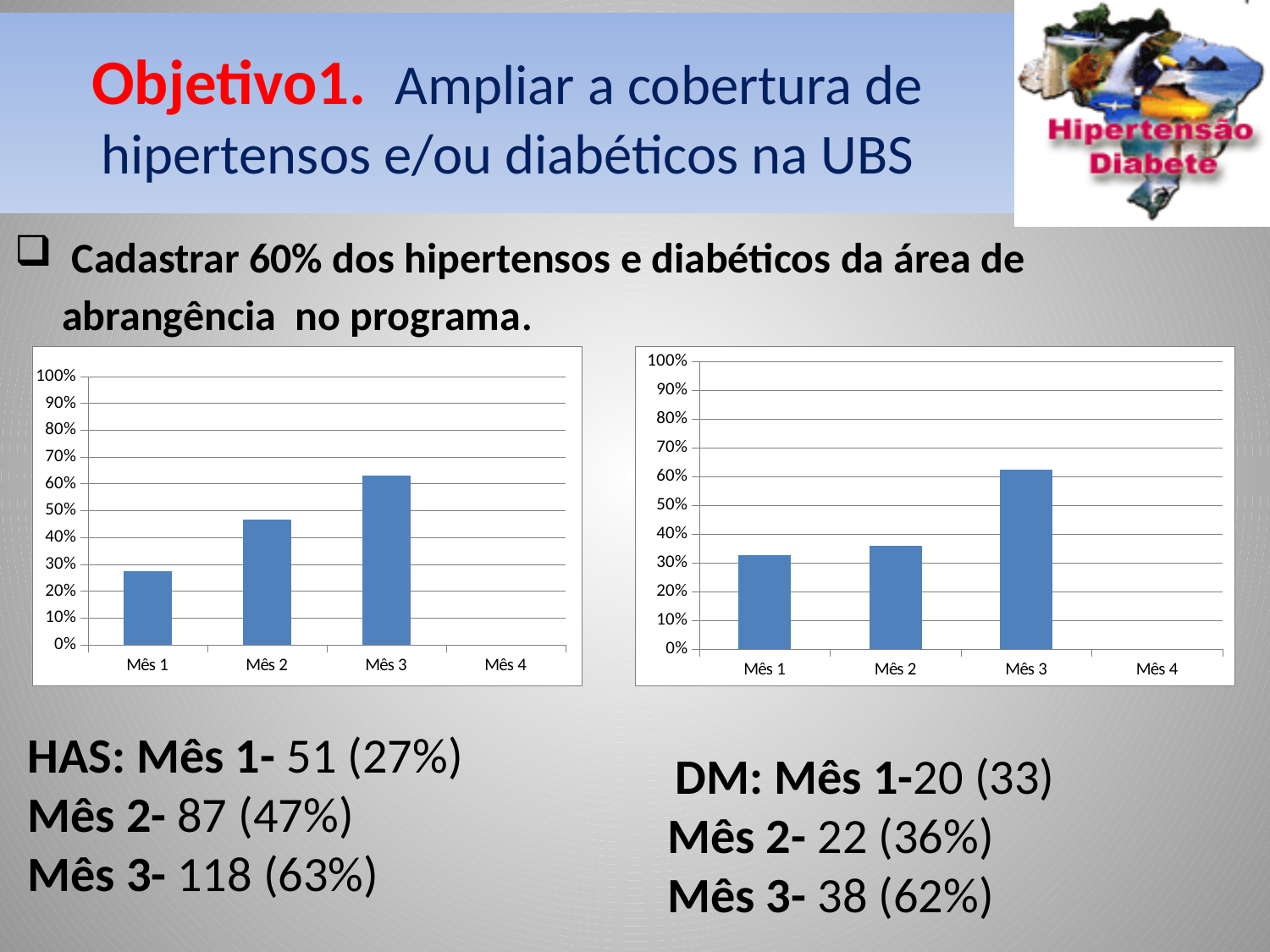
In the chart on the right, how many categories are shown on the x axis? 4 In the chart on the right, which is larger, the value for Mês 2 or the value for Mês 3? Mês 3 In the chart on the right, is the value for Mês 1 greater or less than 40%? less In the chart on the right, which month has the tallest bar? Mês 3 In the chart on the left, is the value for Mês 3 greater or less than 60%? greater What is the highest value shown on the y axis of the chart on the right? 100% In the chart on the right, is the value for Mês 3 greater or less than 50%? greater What kind of chart is the chart on the left of the slide? bar chart In the chart on the left, which month has the tallest bar? Mês 3 In the chart on the left, do the values rise or fall from Mês 1 to Mês 3? rise In the chart on the left, how many categories are shown on the x axis? 4